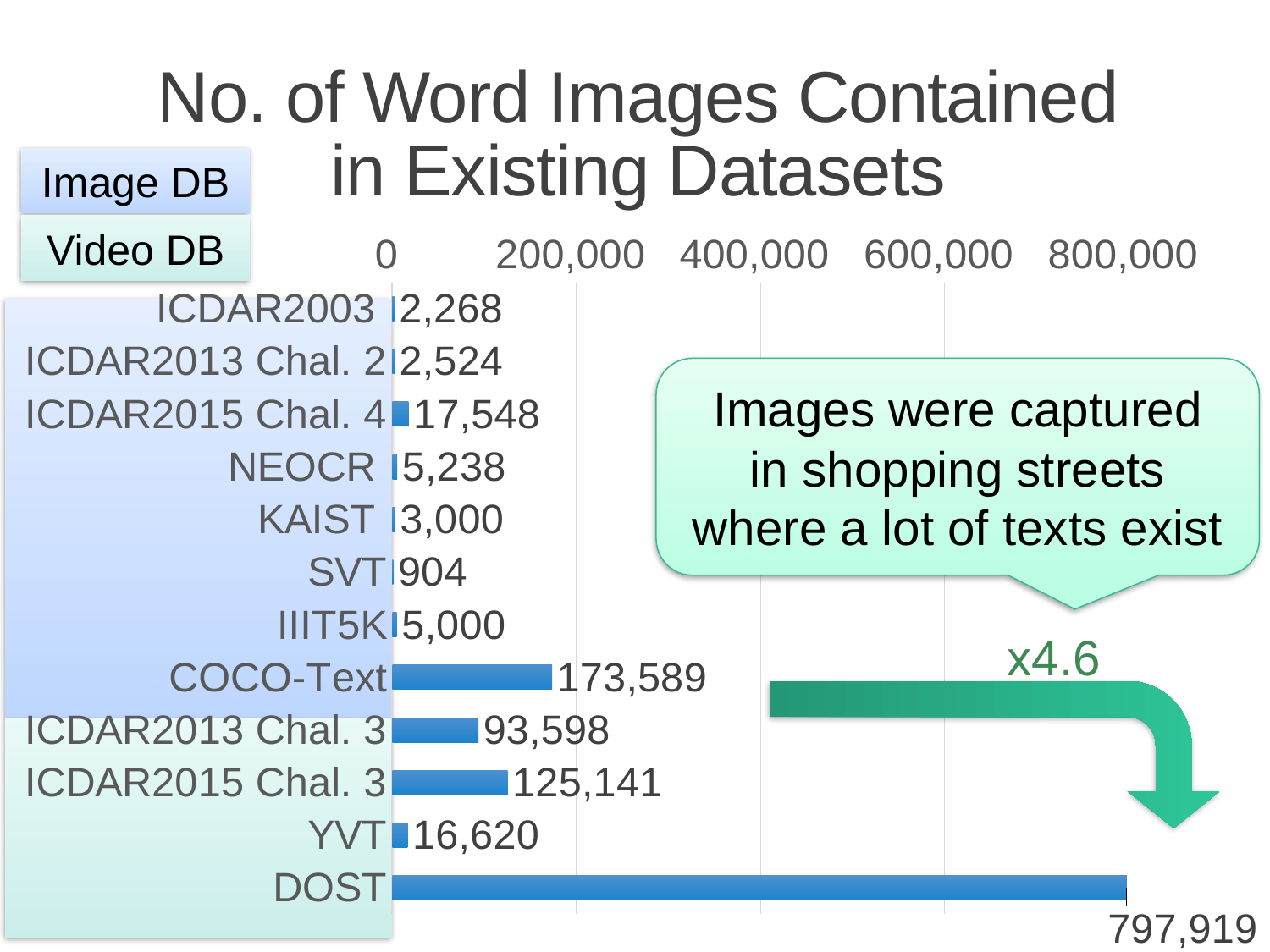
What is the number of word images for COCO-Text? 173,589 Which has more word images, COCO-Text or ICDAR2015 Chal. 3? COCO-Text What is the number of word images for DOST? 797,919 Which dataset has the lowest number of word images? SVT Which dataset has the highest number of word images? DOST What is the number of word images for ICDAR2015 Chal. 4? 17,548 What kind of chart is shown on the slide? bar chart What is the number of word images for YVT? 16,620 Is the value for DOST greater or less than 600,000? greater What is the difference in word images between ICDAR2015 Chal. 3 and ICDAR2013 Chal. 3? 31,543 How many datasets are shown in the chart? 12 What is the title of the chart? No. of Word Images Contained in Existing Datasets